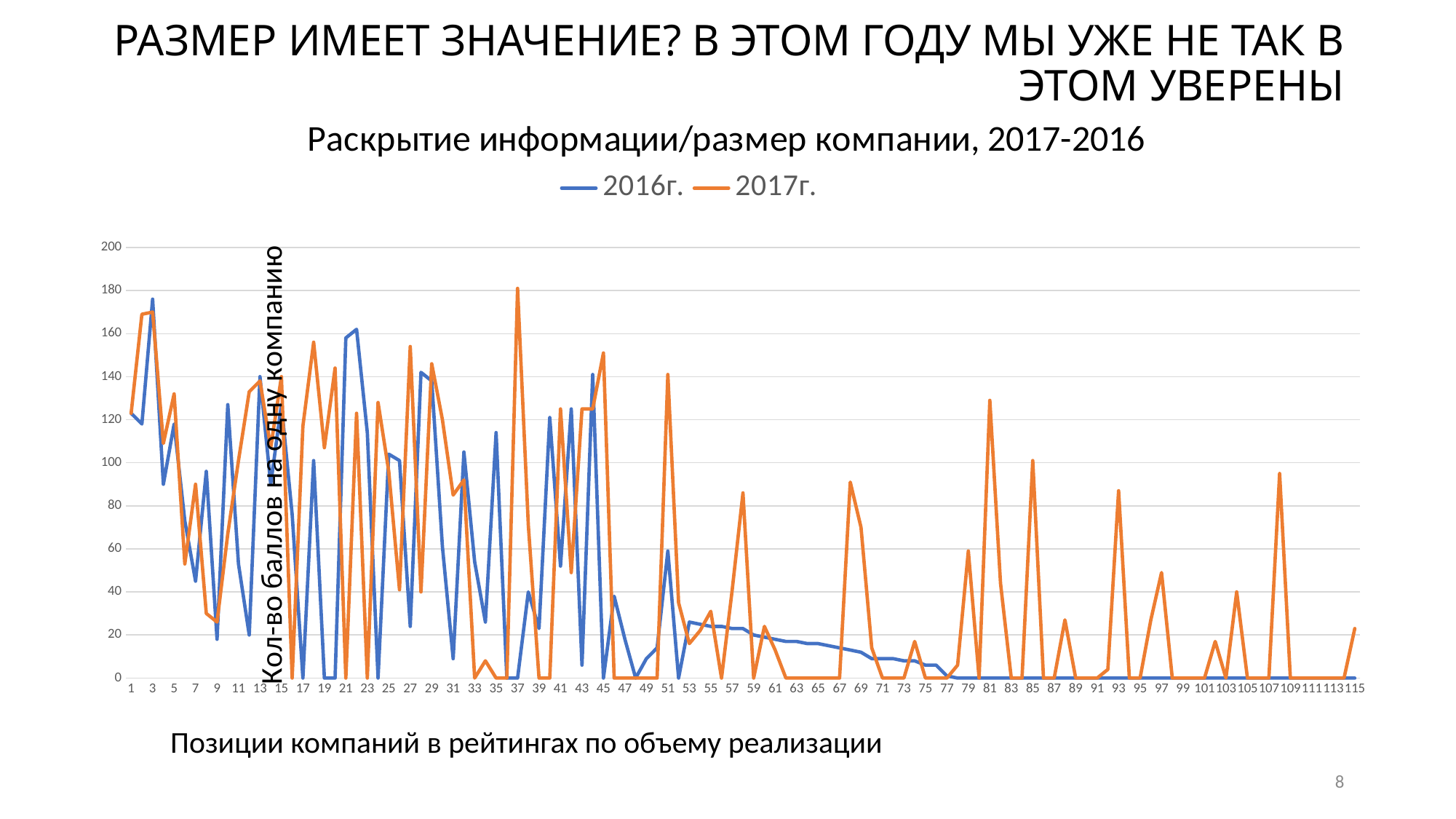
Is the value of the 2017г. series at position 37 greater or less than 160? greater How many series does the legend list? 2 What is the title of the chart? Раскрытие информации/размер компании, 2017-2016 At which position on the x axis does the 2017г. series reach its highest value? 37 Is the value of the 2016г. series at position 81 greater or less than 20? less At position 81, which series has the larger value, 2016г. or 2017г.? 2017г. What are the two series named in the legend? 2016г. and 2017г. At position 37, which series has the larger value, 2016г. or 2017г.? 2017г. Overall, do the values of the 2016г. series rise or fall as the position number increases along the x axis? Fall Is the value of the 2016г. series at position 3 greater or less than 160? greater What kind of chart is shown on the slide? Line chart At which position on the x axis does the 2016г. series reach its highest value? 3